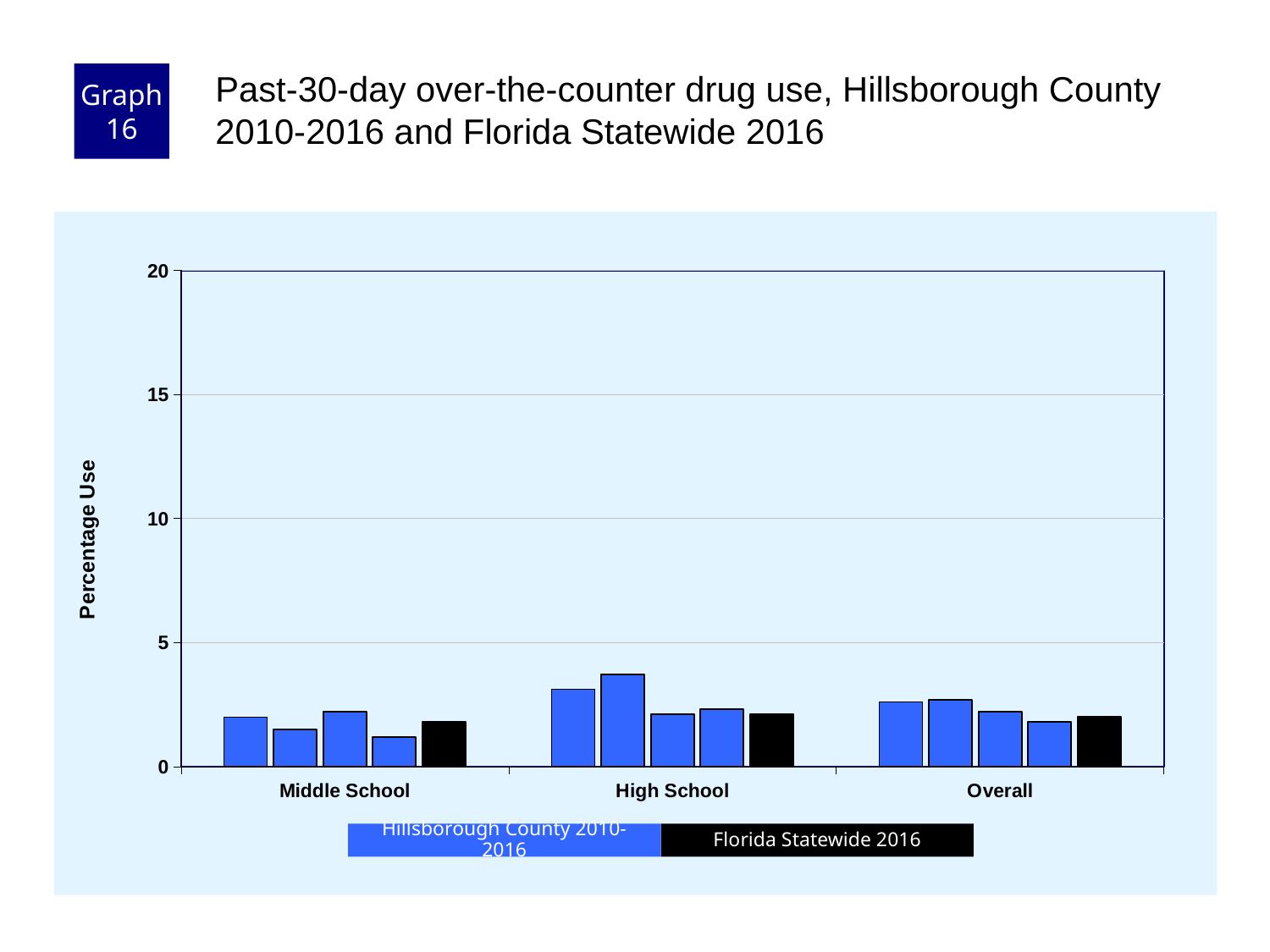
Is the Florida Statewide 2016 value for Middle School greater or less than 5? less Which category has a taller tallest bar, Middle School or High School? High School How many categories are shown along the x axis? 3 Is the Florida Statewide 2016 value for High School greater or less than 5? less Which category contains the tallest bar on the chart? High School Is the Florida Statewide 2016 value for Overall greater or less than 5? less How many series does the legend list? 2 What colour are the Florida Statewide 2016 bars? Black What kind of chart is shown on the slide? Bar chart What is the label on the y axis? Percentage Use